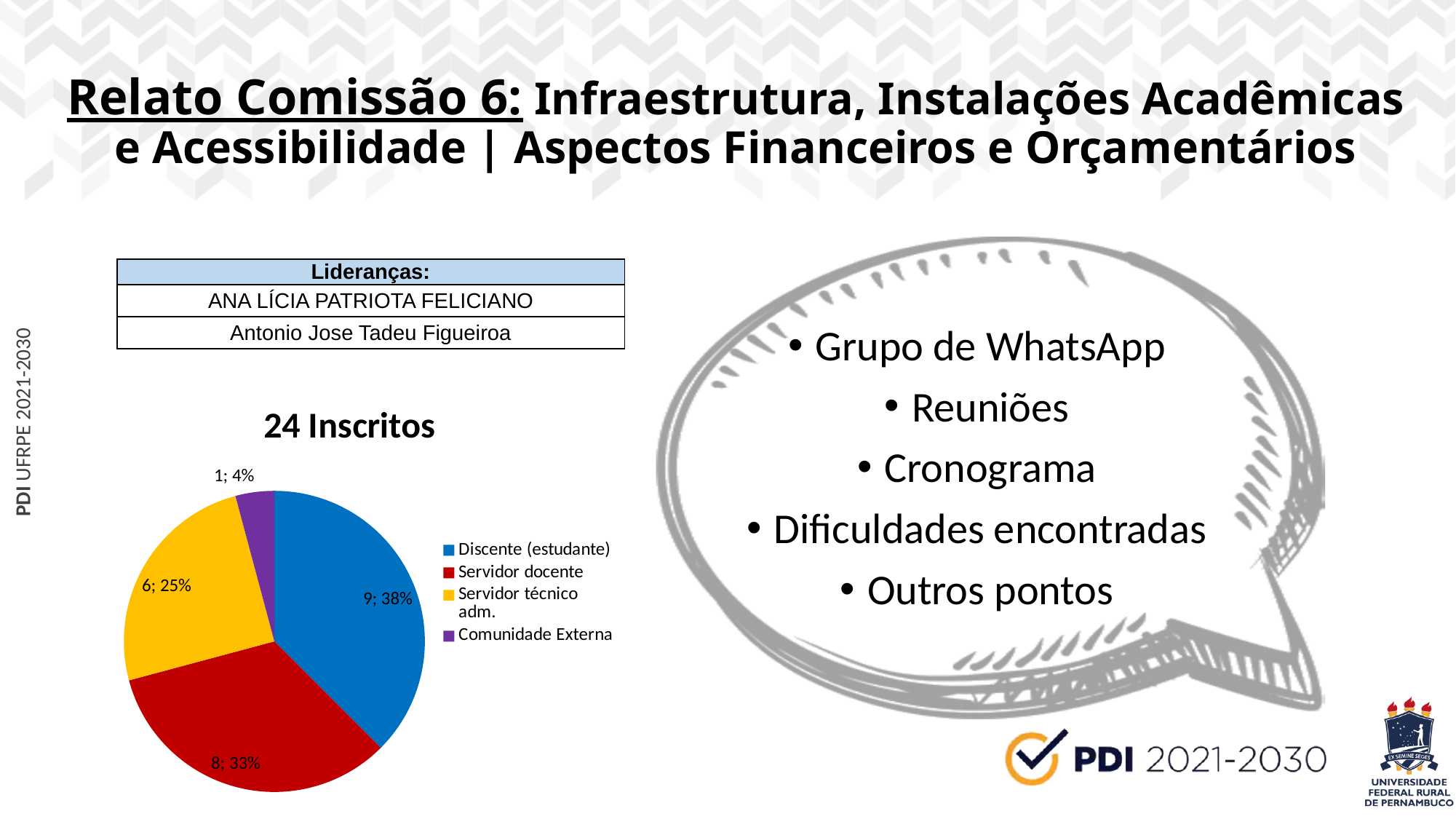
How many entries does the legend of the pie chart list? 4 What type of chart is shown on the slide? pie chart What is the difference in count between Discente (estudante) and Servidor técnico adm.? 3 How many inscritos are in the Discente (estudante) category? 9 What is the title of the pie chart? 24 Inscritos What percentage of the pie does Servidor docente represent? 33% Which category has the smallest slice of the pie? Comunidade Externa How many inscritos are in the Servidor técnico adm. category? 6 What percentage of the pie does Comunidade Externa represent? 4% How many slices does the pie chart have? 4 Which category has the largest slice of the pie? Discente (estudante) Which is larger, the count for Servidor docente or the count for Comunidade Externa? Servidor docente